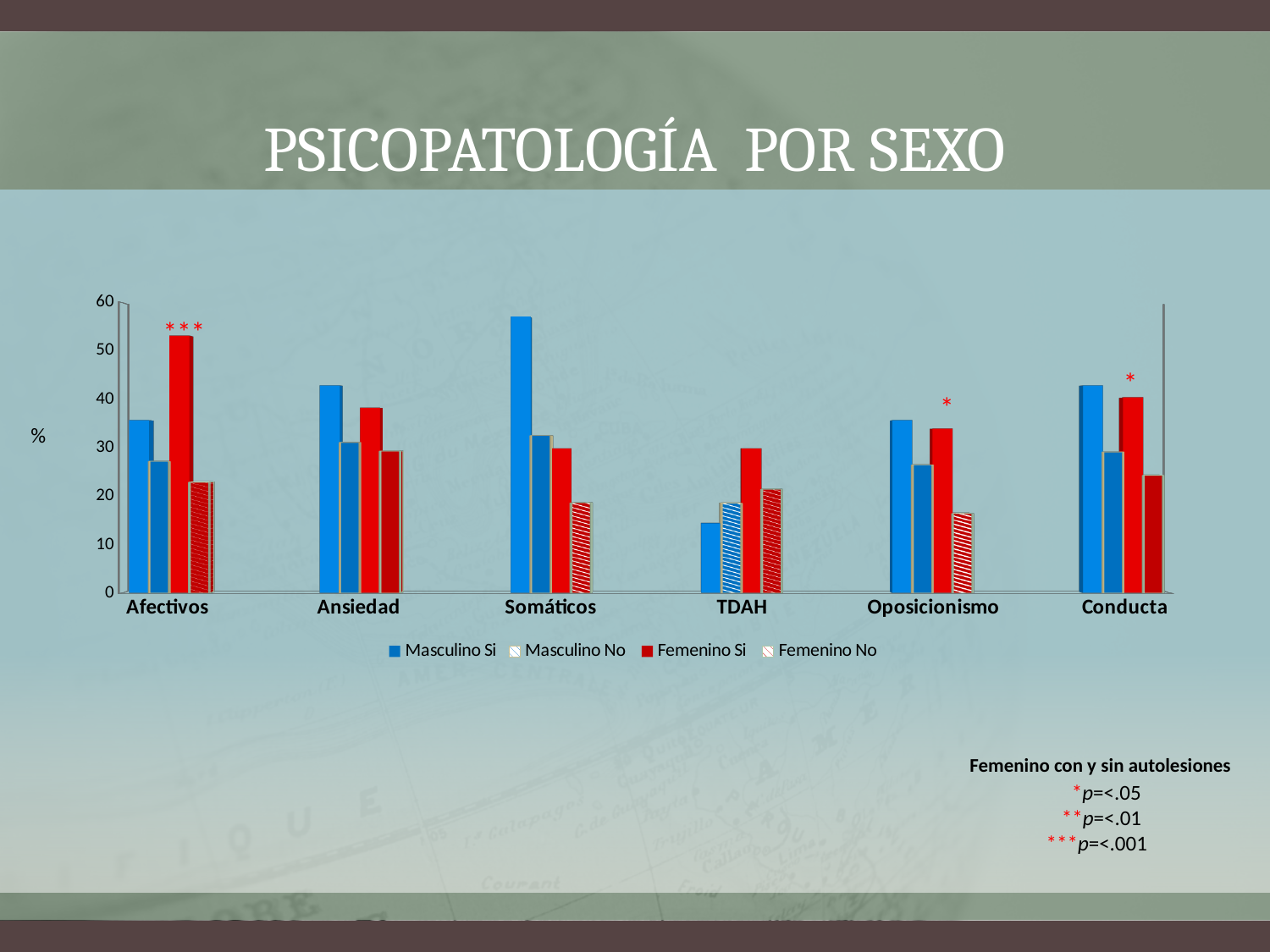
Which category has the highest value for Femenino Si? Afectivos Which category has the lowest value for Masculino Si? TDAH In Somáticos, which is larger: Masculino Si or Femenino Si? Masculino Si Is the value for Masculino Si in Somáticos greater or less than 50? greater In Afectivos, which is larger: Femenino Si or Masculino Si? Femenino Si Which category has the highest value for Masculino Si? Somáticos What is the title of the slide? PSICOPATOLOGÍA POR SEXO How many categories are shown on the x axis? 6 What kind of chart is shown on the slide? bar chart Is the value for Femenino No in Oposicionismo greater or less than 20? less How many series does the legend list? 4 Is the value for Masculino Si in TDAH greater or less than 20? less